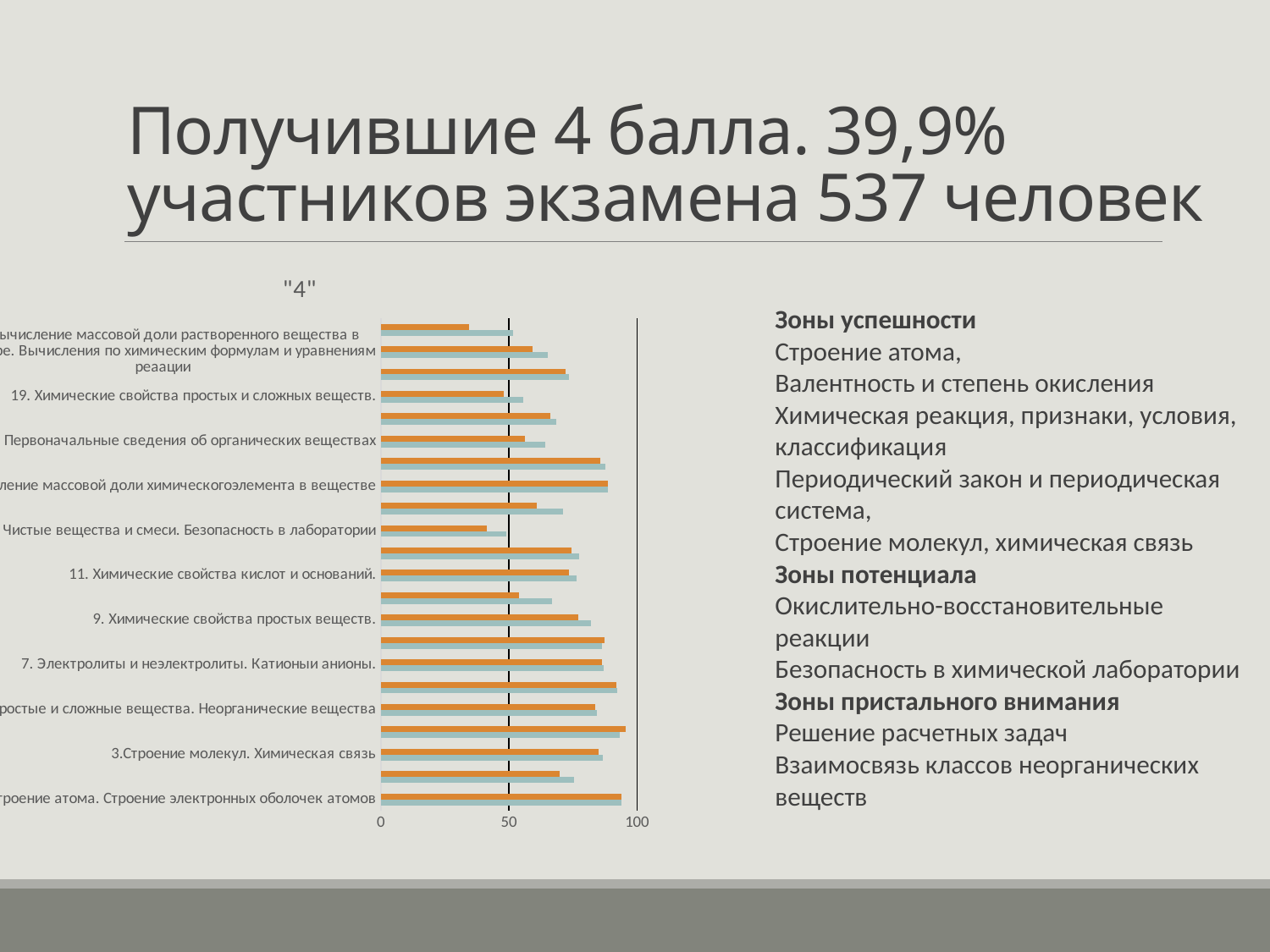
Is the orange bar for "7. Электролиты и неэлектролиты. Катионы и анионы." greater or less than 50? greater Is the orange bar for "Чистые вещества и смеси. Безопасность в лаборатории" greater or less than 50? less Which has the larger orange bar: "Чистые вещества и смеси. Безопасность в лаборатории" or "7. Электролиты и неэлектролиты. Катионы и анионы."? 7. Электролиты и неэлектролиты. Катионы и анионы. Is the orange bar for "9. Химические свойства простых веществ." greater or less than 50? greater Which has the larger orange bar: "19. Химические свойства простых и сложных веществ." or "7. Электролиты и неэлектролиты. Катионы и анионы."? 7. Электролиты и неэлектролиты. Катионы и анионы. What kind of chart is shown on the slide? bar chart Which has the larger orange bar: "9. Химические свойства простых веществ." or "Чистые вещества и смеси. Безопасность в лаборатории"? 9. Химические свойства простых веществ. What is the title of the chart? "4" What is the highest value shown on the chart's horizontal axis? 100